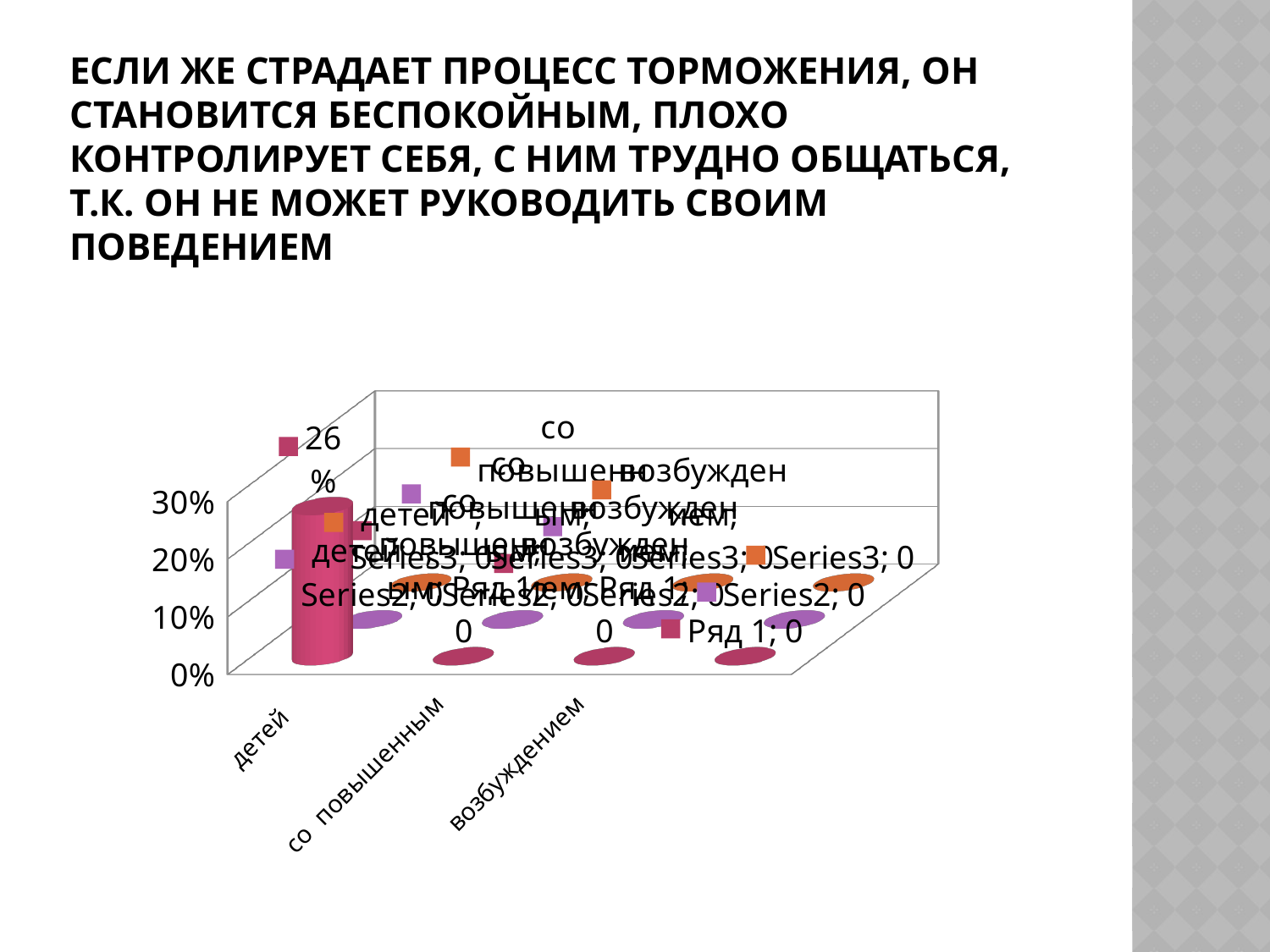
What value is shown in the data label "Ряд 1; 0" for the series Ряд 1 at the category "возбуждением"? 0 What is the highest tick value shown on the vertical axis? 30% Which category has the highest bar? детей How many categories are shown on the x axis? 3 Is the value for "детей" greater or less than 20%? greater Which is larger: the value for "детей" or the value for "возбуждением" in series Ряд 1? детей What value is labelled on the bar for the category "детей"? 26% Is the value for "детей" greater or less than 30%? less What kind of chart is shown on the slide? bar chart What is the lowest tick value shown on the vertical axis? 0%